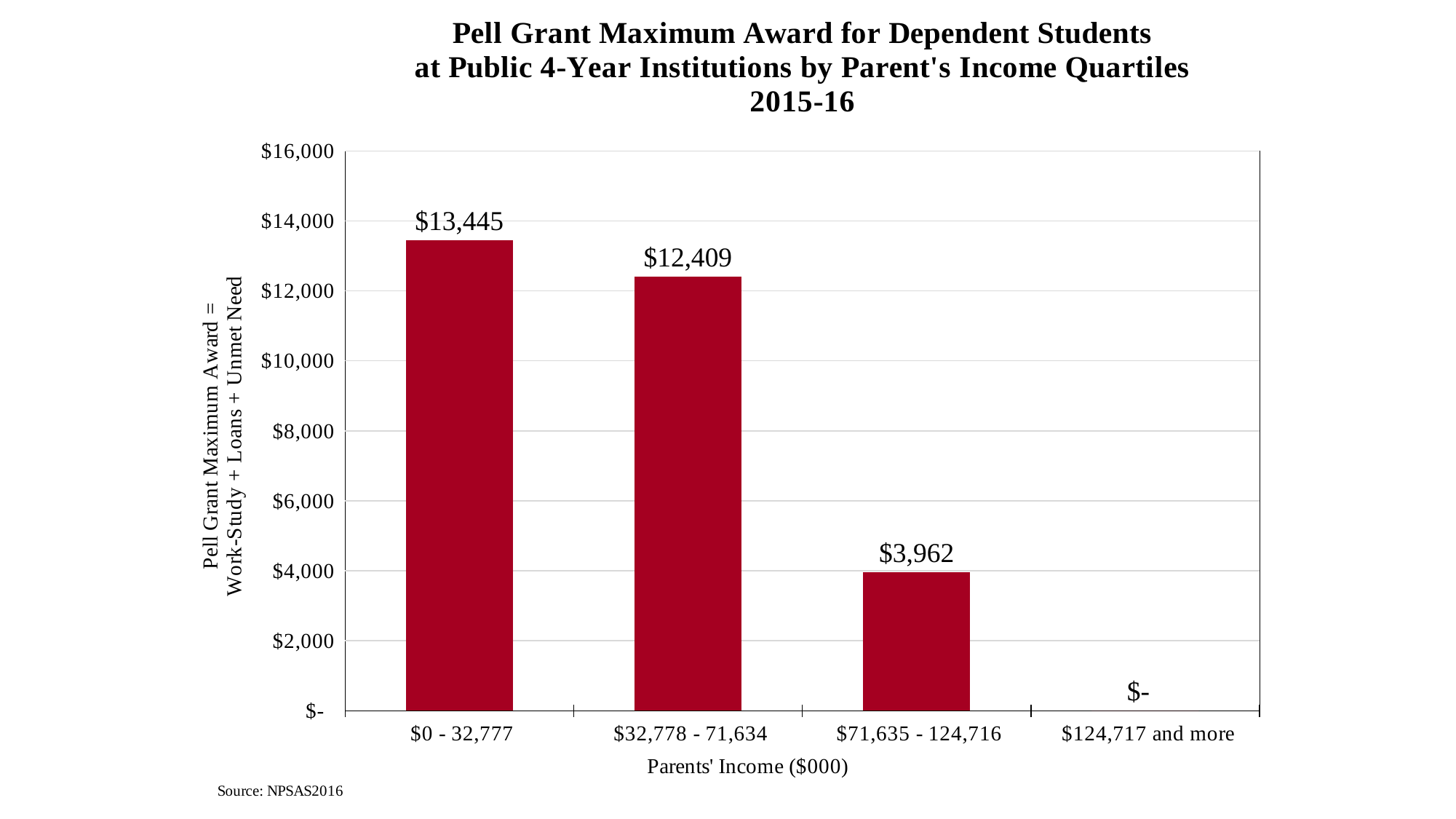
Which parents' income quartile has the lowest Pell Grant maximum award? $124,717 and more What kind of chart is shown on the slide? Bar chart Which parents' income quartile has the highest Pell Grant maximum award? $0 - 32,777 What is the Pell Grant maximum award for the $32,778 - 71,634 parents' income quartile? $12,409 What is the Pell Grant maximum award for the $71,635 - 124,716 parents' income quartile? $3,962 What is the difference between the Pell Grant maximum award for the $0 - 32,777 quartile and the $32,778 - 71,634 quartile? $1,036 Do the Pell Grant maximum award values rise or fall as parents' income increases along the x axis? Fall Which is larger, the award for the $32,778 - 71,634 quartile or the $71,635 - 124,716 quartile? $32,778 - 71,634 How many parents' income quartiles are shown on the x axis? 4 What is the Pell Grant maximum award for the $0 - 32,777 parents' income quartile? $13,445 What is the difference between the Pell Grant maximum award for the $32,778 - 71,634 quartile and the $71,635 - 124,716 quartile? $8,447 What value is shown for the $124,717 and more parents' income quartile? $-